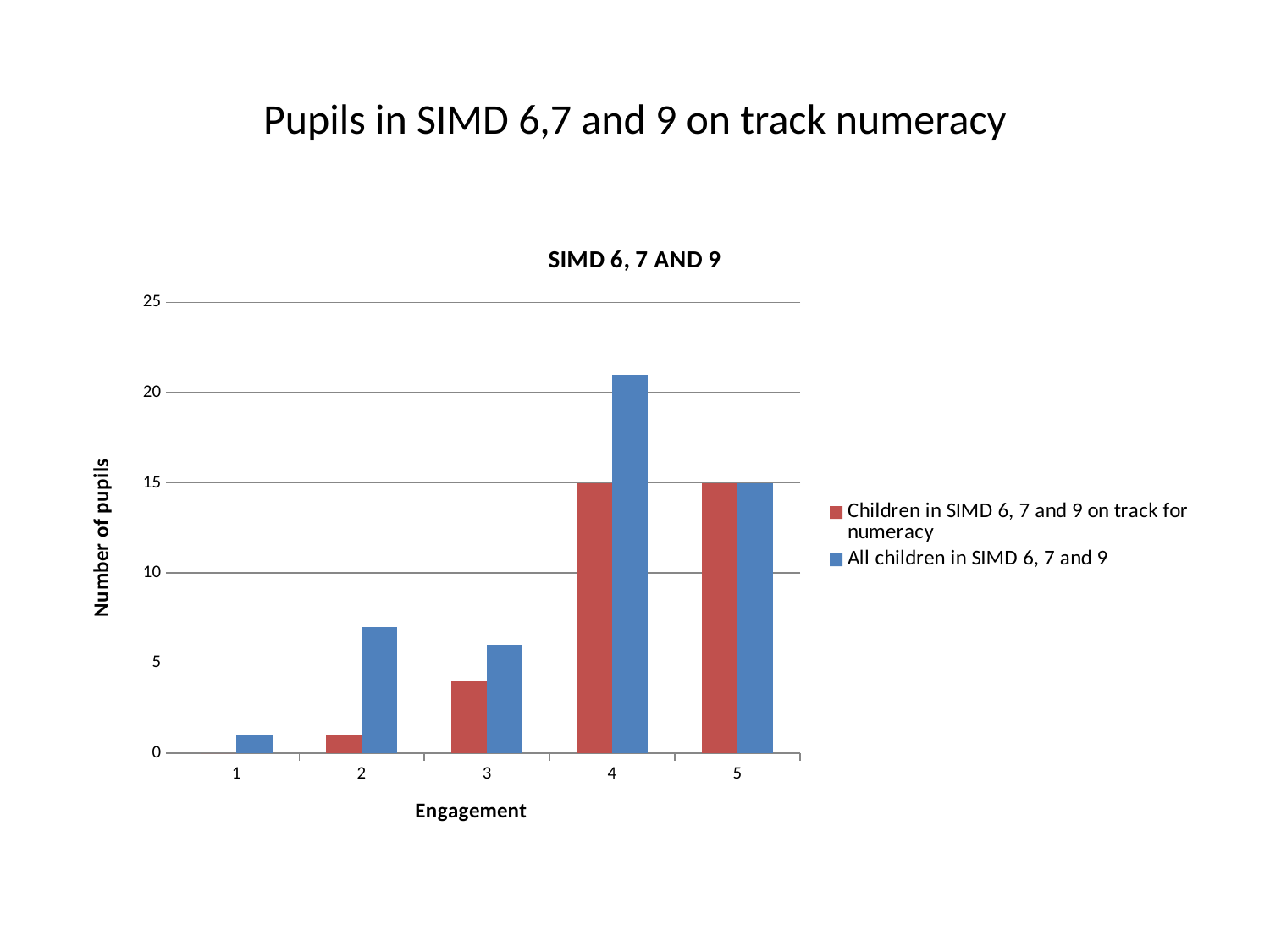
What is the title of the chart's vertical axis? Number of pupils At engagement 4, which series has the larger value: 'Children in SIMD 6, 7 and 9 on track for numeracy' or 'All children in SIMD 6, 7 and 9'? All children in SIMD 6, 7 and 9 What is the value for 'All children in SIMD 6, 7 and 9' at engagement 5? 15 What is the value for 'Children in SIMD 6, 7 and 9 on track for numeracy' at engagement 4? 15 How many engagement categories are shown on the x axis? 5 What is the value for 'Children in SIMD 6, 7 and 9 on track for numeracy' at engagement 5? 15 How many series does the legend list? 2 Is the value for 'All children in SIMD 6, 7 and 9' at engagement 2 greater or less than 5? greater At which engagement level is the value for 'All children in SIMD 6, 7 and 9' highest? 4 Is the value for 'All children in SIMD 6, 7 and 9' at engagement 4 greater or less than 20? greater What kind of chart is shown on the slide? bar chart Is the value for 'Children in SIMD 6, 7 and 9 on track for numeracy' at engagement 3 greater or less than 5? less